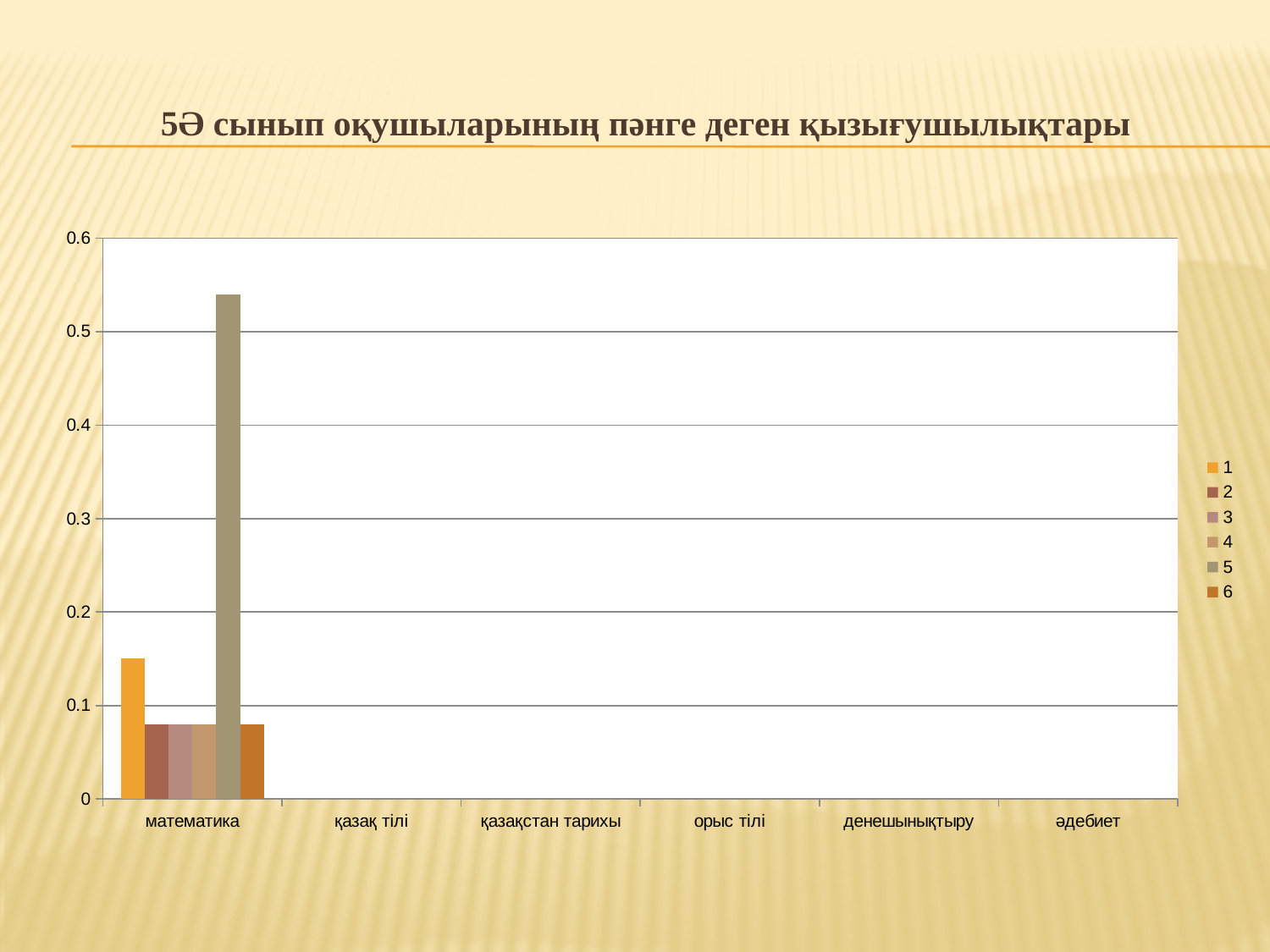
Is the value of series 5 for математика greater or less than 0.6? less How many categories are shown along the x axis? 6 For математика, which is larger: the value of series 1 or the value of series 6? series 1 Is the value of series 2 for математика greater or less than 0.1? less Is the value of series 1 for математика greater or less than 0.1? greater Which category has visible bars in the chart? математика What kind of chart is shown on the slide? bar chart For математика, which is larger: the value of series 1 or the value of series 5? series 5 What is the title of the slide? 5Ә сынып оқушыларының пәнге деген қызығушылықтары Which series has the tallest bar for математика? 5 How many series does the legend list? 6